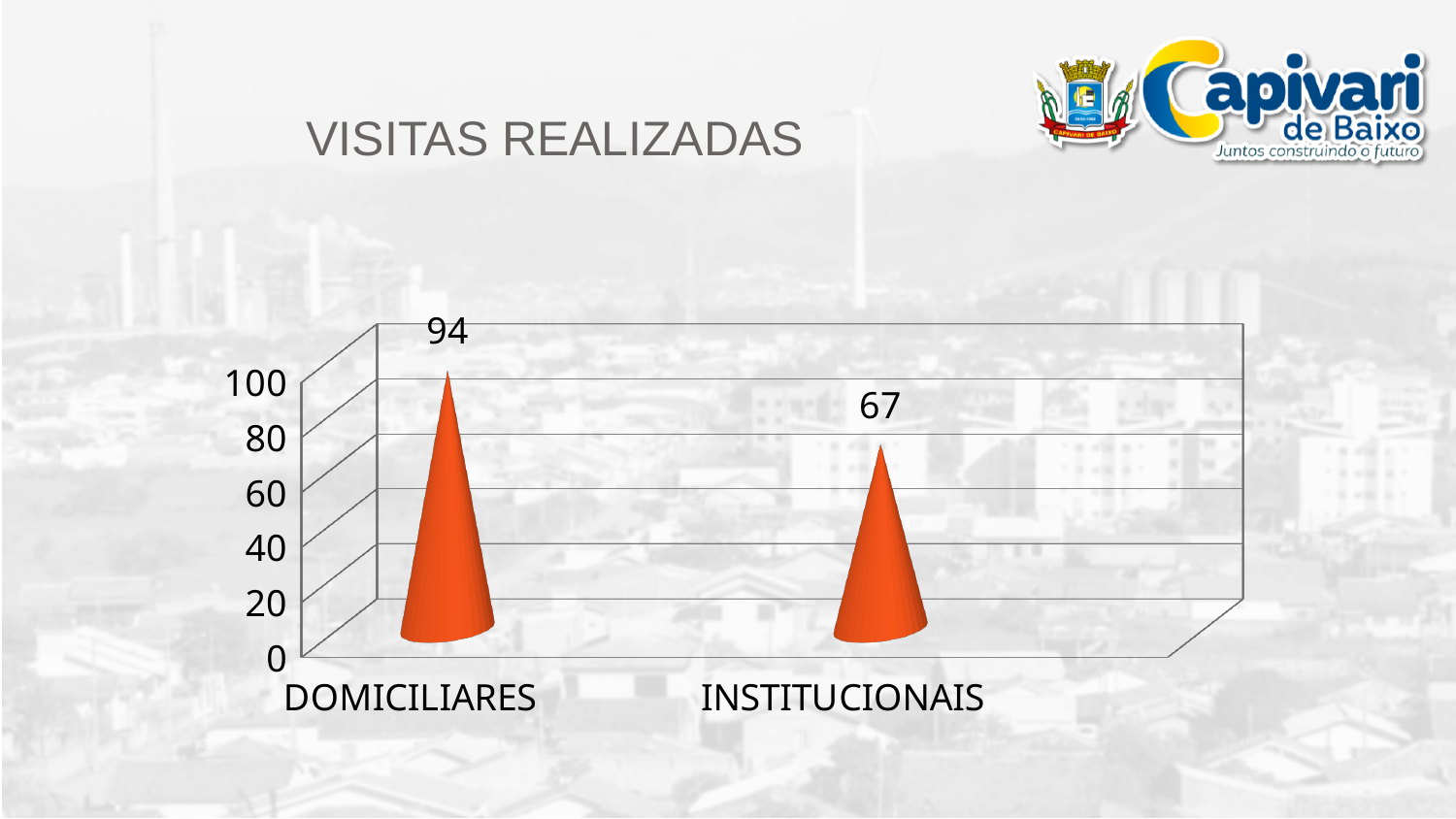
Is the value for INSTITUCIONAIS greater or less than 80? less What is the value for INSTITUCIONAIS? 67 Which category has the highest value? DOMICILIARES What is the difference between the values for DOMICILIARES and INSTITUCIONAIS? 27 How many categories are shown on the chart? 2 What is the value for DOMICILIARES? 94 What is the highest value shown on the vertical axis? 100 Which category has the lowest value? INSTITUCIONAIS What kind of chart is shown on the slide? bar chart Is the value for DOMICILIARES greater or less than 80? greater Which is larger, the value for DOMICILIARES or the value for INSTITUCIONAIS? DOMICILIARES What is the title of the slide? VISITAS REALIZADAS